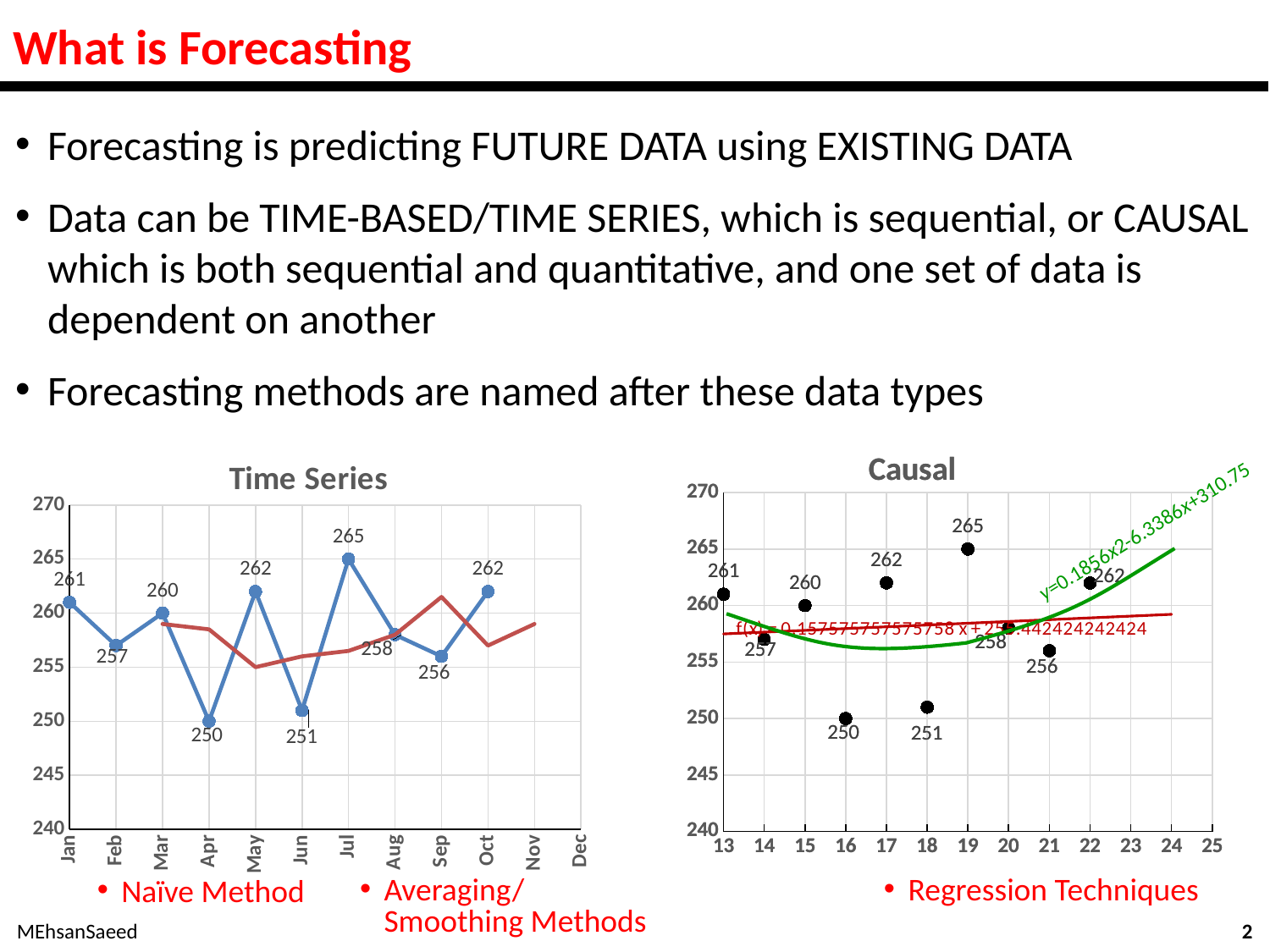
In the Time Series chart, how many data points are labelled on the blue line? 10 In the Time Series chart, which month has the highest value on the blue line? Jul In the Time Series chart, what is the value for Jul? 265 In the Causal chart, what is the value of the point at x = 19? 265 What kind of chart is the Time Series chart? line chart In the Time Series chart, is the value of the red line at Nov greater or less than 255? greater In the Time Series chart, which month has the lowest value on the blue line? Apr In the Causal chart, what is the difference between the point at x = 17 and the point at x = 21? 6 In the Time Series chart, which is larger, the value for May or the value for Mar? May In the Time Series chart, what is the difference between the Jul value and the Apr value? 15 What kind of chart is the Causal chart? scatter chart In the Causal chart, at which x value is the lowest point? 16